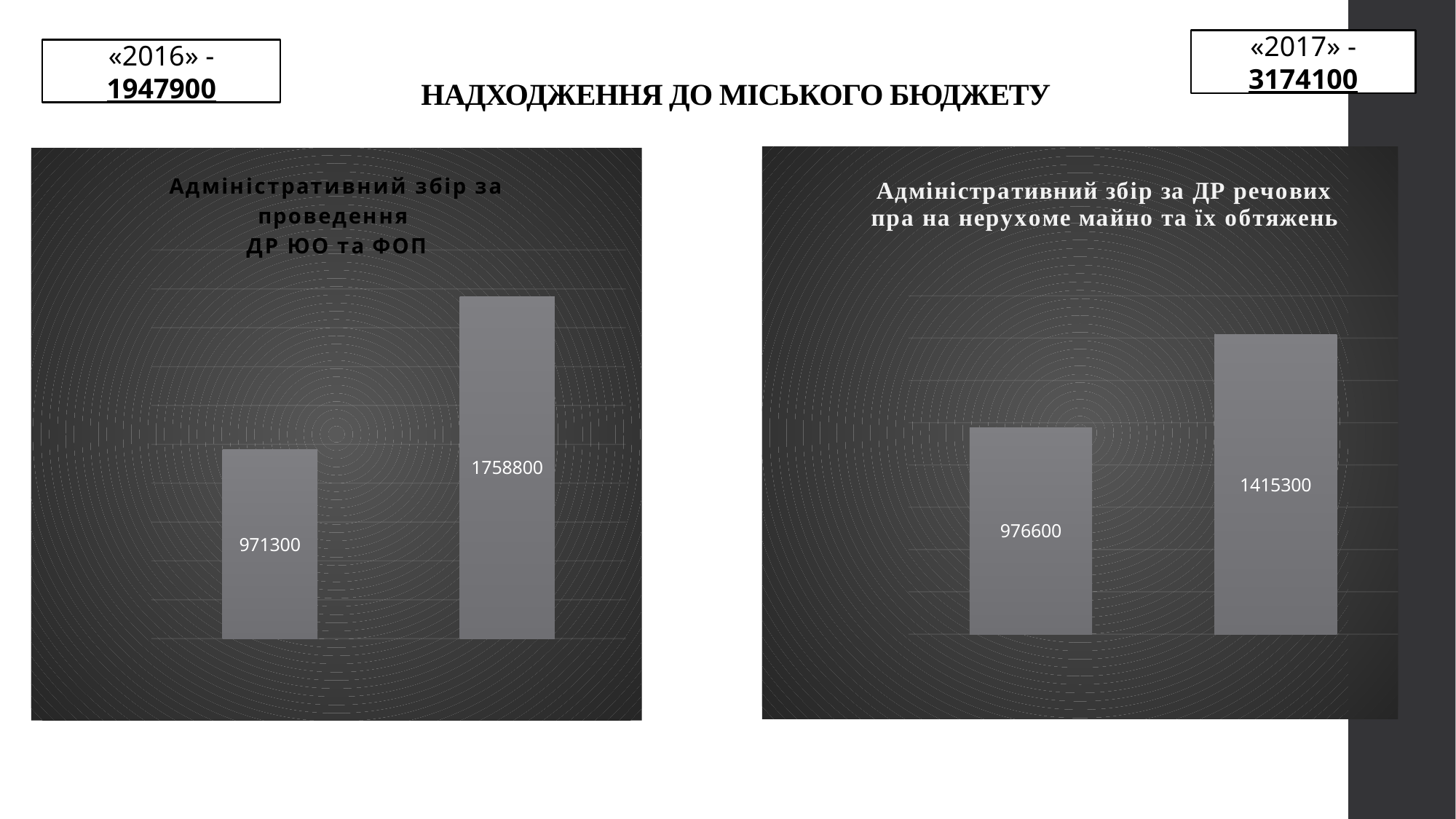
How many bars does the left chart show? 2 In the right chart, which bar is lower, the left or the right? the left bar In the right chart (Адміністративний збір за ДР речових пра на нерухоме майно та їх обтяжень), what is the value of the left bar? 976600 In the left chart (Адміністративний збір за проведення ДР ЮО та ФОП), what is the value of the left bar? 971300 In the right chart, what is the difference between the two bars? 438700 What type of chart is the right chart? bar chart In the right chart, do the values rise or fall from left to right? rise In the left chart, what is the difference between the two bars? 787500 In the left chart (Адміністративний збір за проведення ДР ЮО та ФОП), what is the value of the right bar? 1758800 In the left chart, which bar is higher, the left or the right? the right bar In the right chart (Адміністративний збір за ДР речових пра на нерухоме майно та їх обтяжень), what is the value of the right bar? 1415300 What is the title of the left chart? Адміністративний збір за проведення ДР ЮО та ФОП